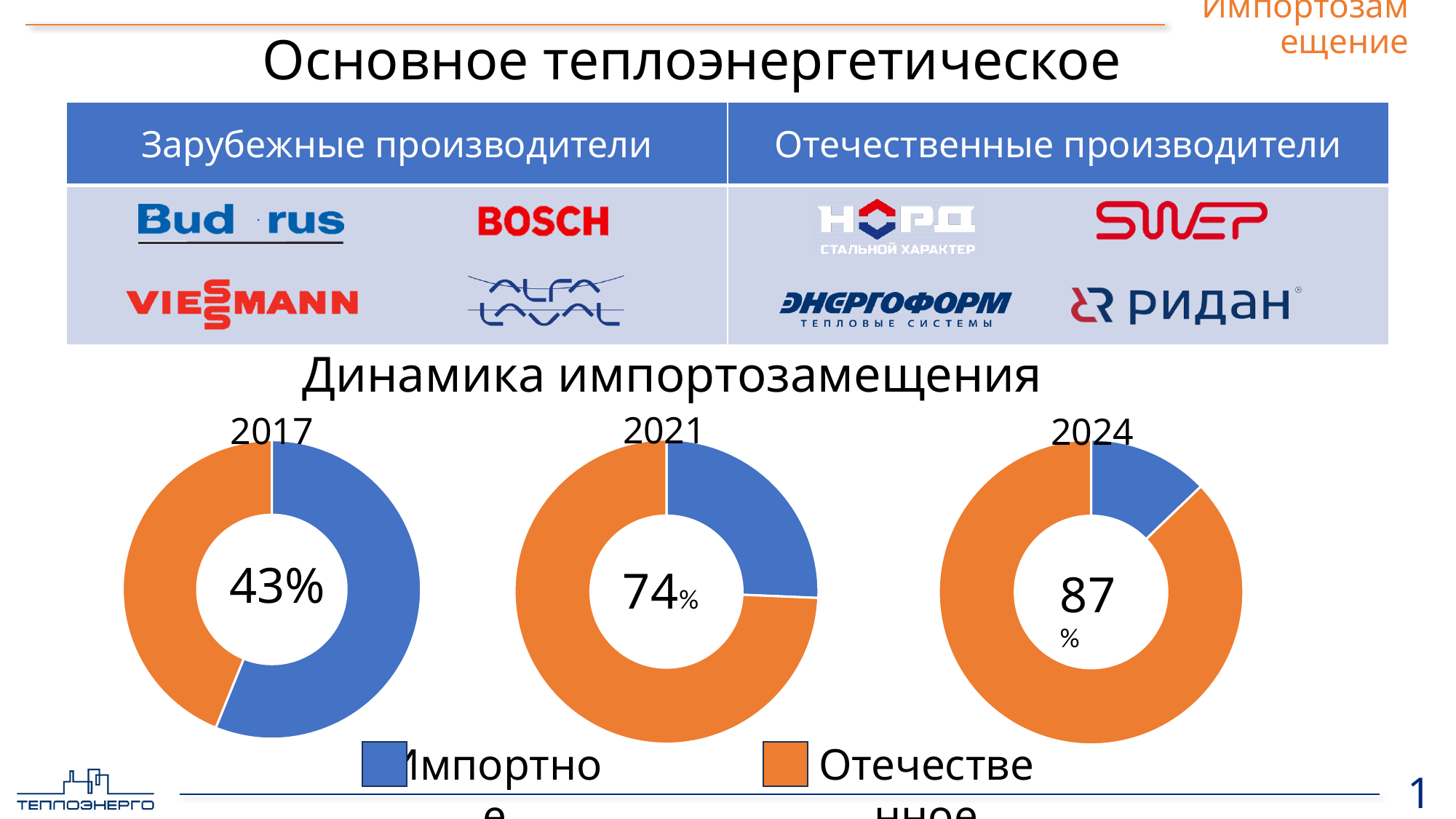
What value is shown in the centre of the 2024 donut chart? 87% How many donut charts are shown under 'Динамика импортозамещения'? 3 Which year's donut chart shows the lowest percentage in its centre? 2017 Which legend entry is shown in orange? Отечественное What value is shown in the centre of the 2017 donut chart? 43% What value is shown in the centre of the 2021 donut chart? 74% What is the difference between the percentage shown for 2024 and the percentage shown for 2017? 44% Do the percentages shown in the donut charts rise or fall from 2017 to 2024? rise What is the difference between the percentage shown for 2021 and the percentage shown for 2017? 31% What kind of charts are used in the 'Динамика импортозамещения' section? donut (pie) charts Which is larger, the percentage shown for 2021 or the percentage shown for 2024? 2024 Which year's donut chart shows the highest percentage in its centre? 2024